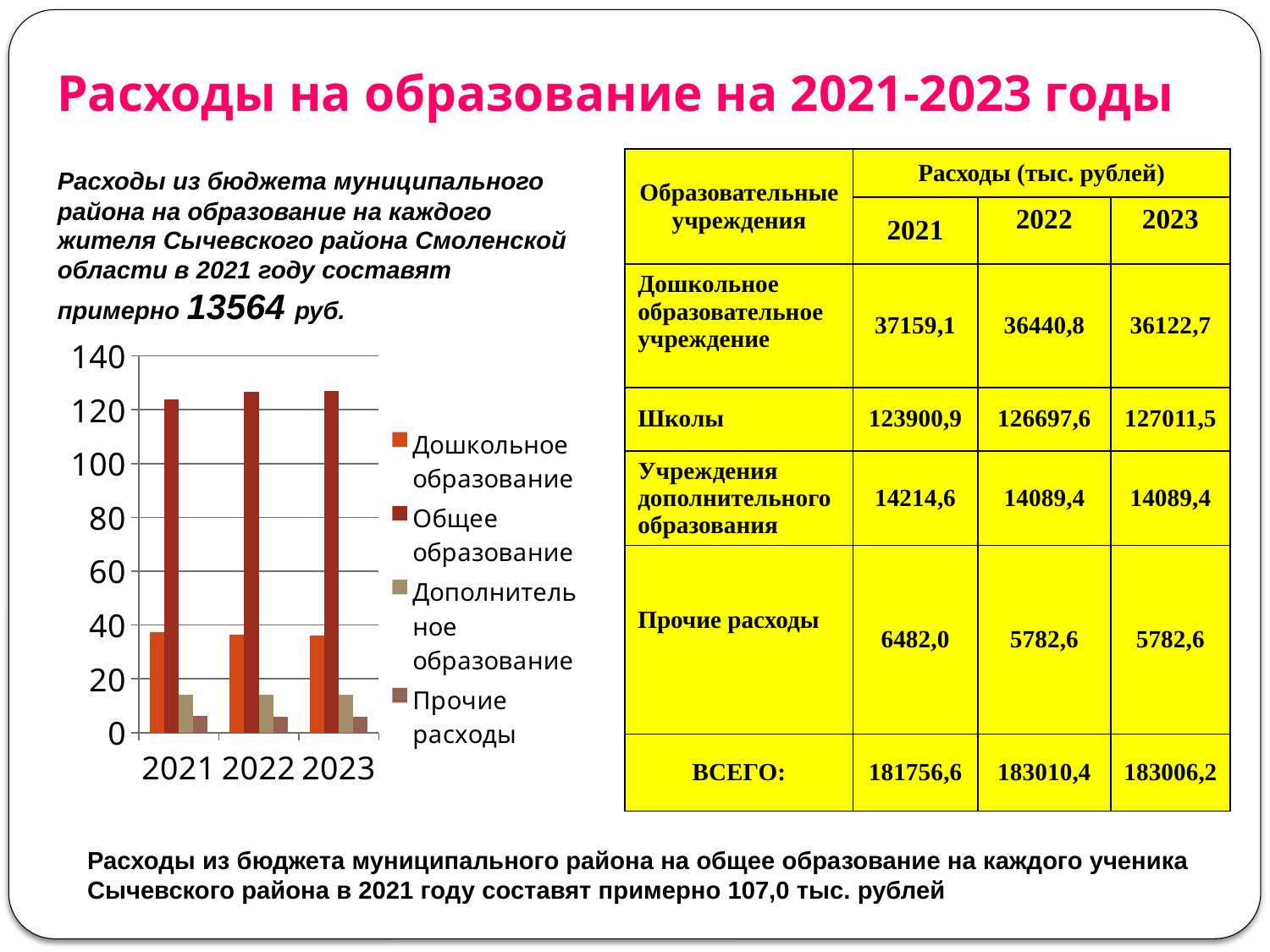
In the bar chart, which is larger in 2022: Дошкольное образование or Дополнительное образование? Дошкольное образование In the bar chart, is the value for Дошкольное образование in 2022 greater or less than 40? less How many years (categories) are shown on the x axis of the bar chart? 3 In the bar chart, is the value for Прочие расходы in 2023 greater or less than 20? less In the bar chart, which series has the highest bar in 2021? Общее образование In the bar chart, does the value for Общее образование rise or fall from 2021 to 2023? rise In the bar chart, is the value for Общее образование in 2021 greater or less than 100? greater How many series does the legend of the bar chart list? 4 In the bar chart, which series has the lowest bar in 2023? Прочие расходы What is the highest tick value shown on the vertical axis of the bar chart? 140 What kind of chart is shown on the slide? bar chart